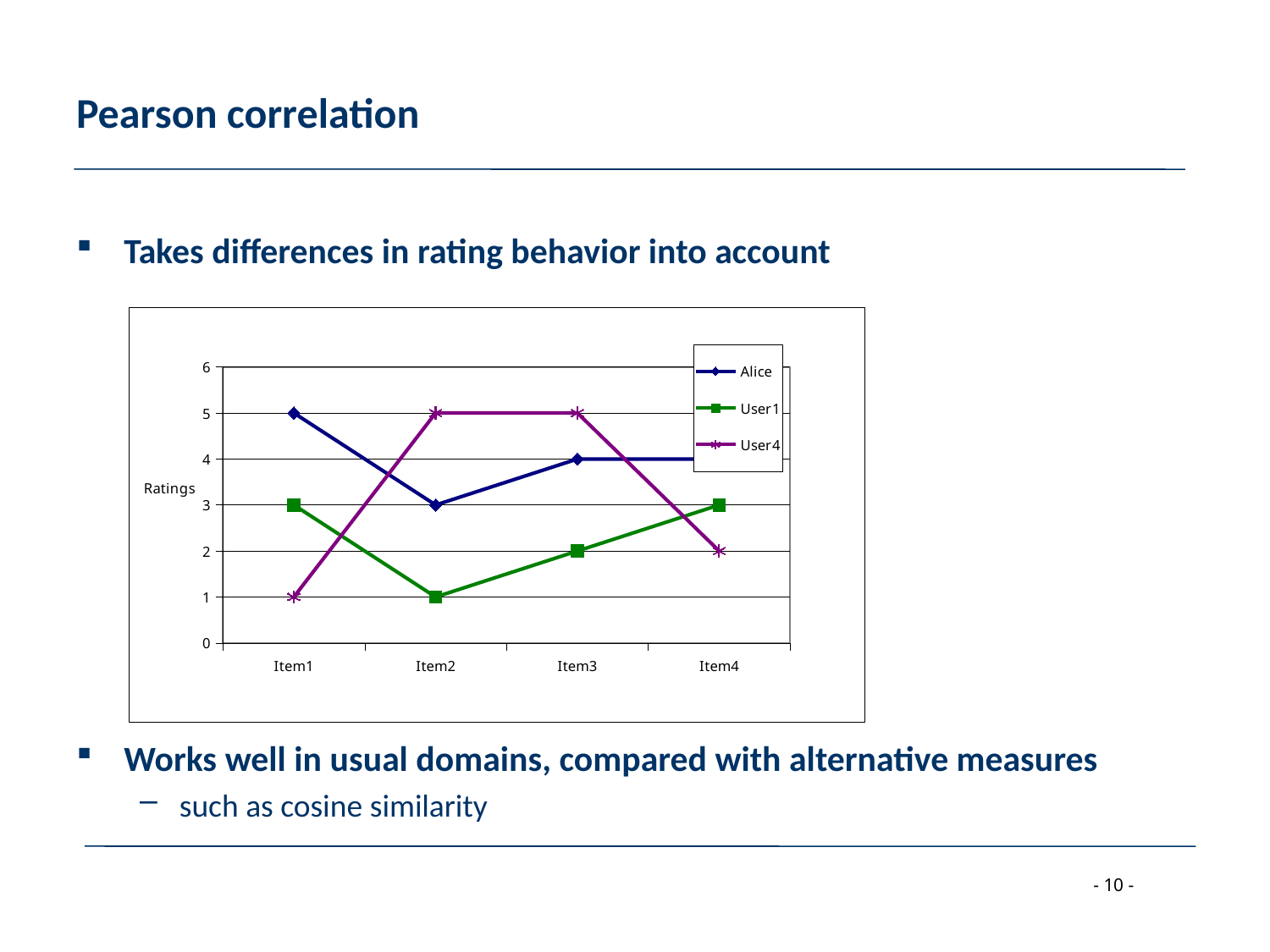
What type of chart is shown on the slide? line chart What is User1's rating for Item2? 1 How many items are shown on the x axis? 4 Does User1's rating rise or fall from Item2 to Item4? rise How many series does the legend list? 3 What is the label of the vertical axis? Ratings What is the difference between Alice's and User1's ratings for Item3? 2 What is Alice's rating for Item1? 5 For which item does User1 have the lowest rating? Item2 What is User4's rating for Item4? 2 For which item does Alice have the highest rating? Item1 Which is larger for Item2: Alice's rating or User4's rating? User4